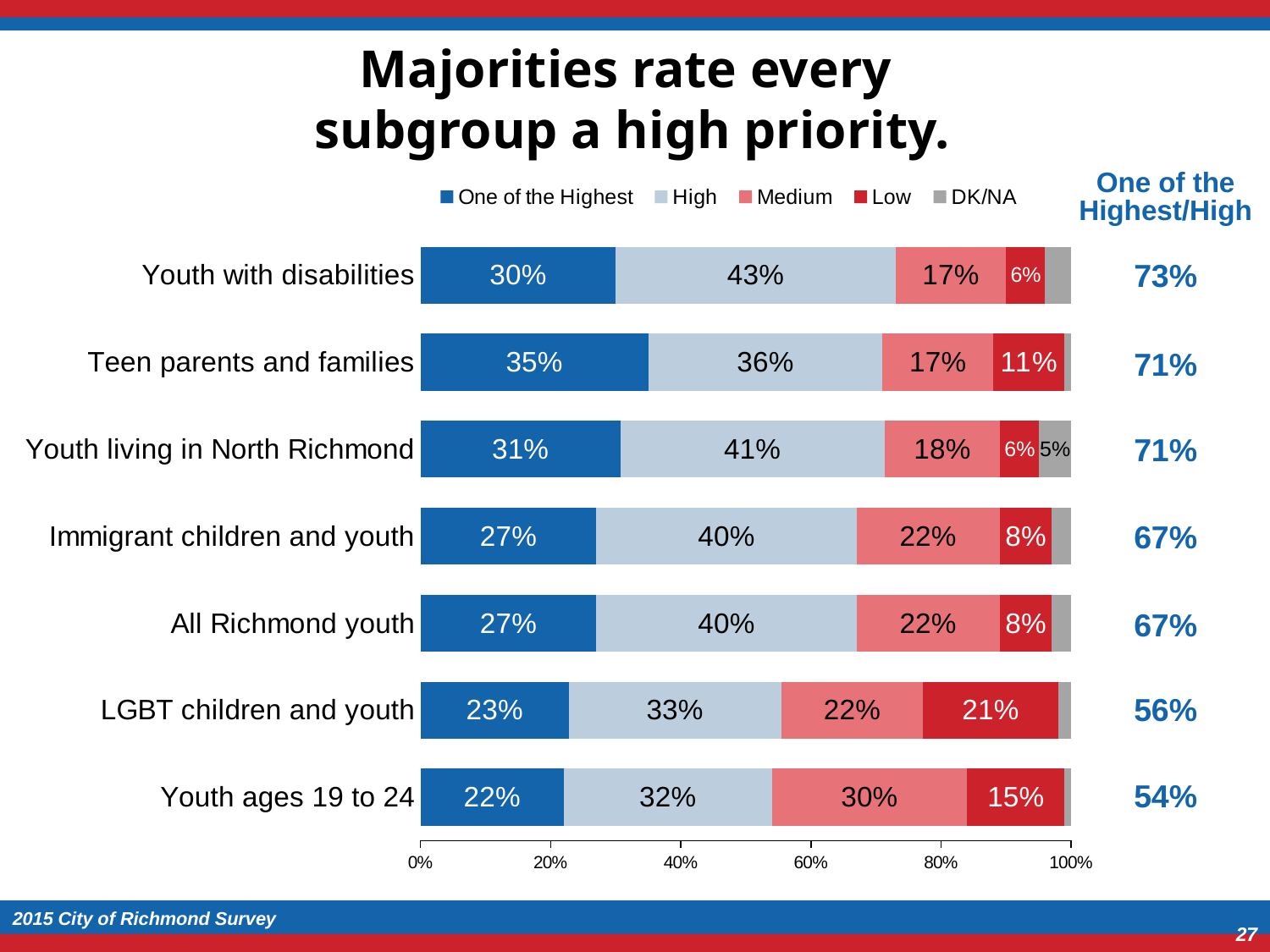
What is the difference between the Low value for "LGBT children and youth" and the Low value for "Youth with disabilities"? 15% What is the combined One of the Highest/High figure shown for "Youth with disabilities"? 73% What kind of chart is shown on the slide? Stacked bar chart What is the Low value for "LGBT children and youth"? 21% Which has a larger High value: "Youth with disabilities" or "Teen parents and families"? Youth with disabilities What is the Medium value for "Youth ages 19 to 24"? 30% How many series does the legend list? 5 What percentage of respondents rated "Teen parents and families" as One of the Highest priority? 35% What is the title of the slide? Majorities rate every subgroup a high priority. Which subgroup has the lowest combined One of the Highest/High figure? Youth ages 19 to 24 Which subgroup has the highest One of the Highest value? Teen parents and families How many subgroups are shown in the chart? 7